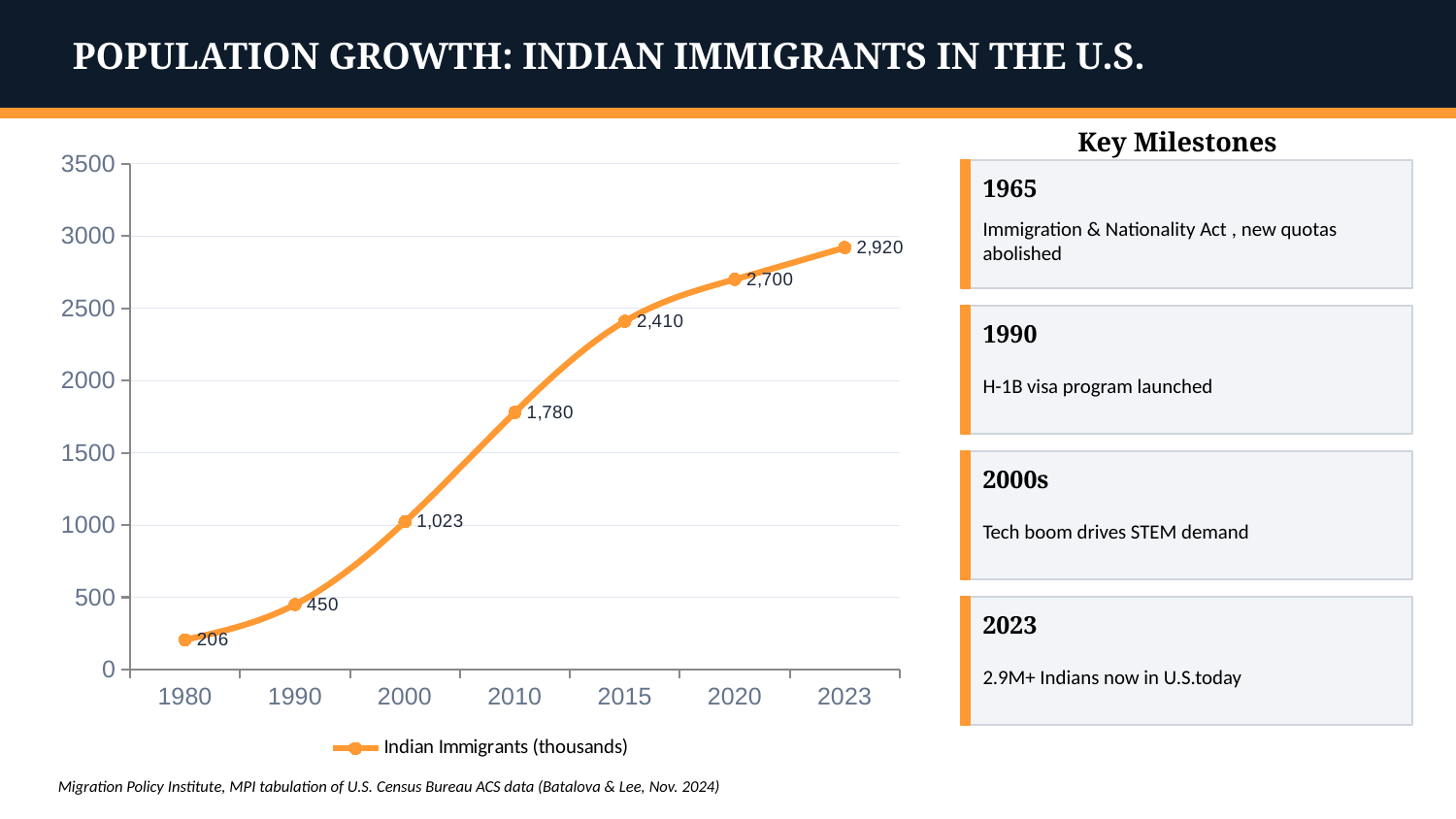
What is the value for 2010? 1,780 How many series does the legend list? 1 What is the difference between the values for 2000 and 1990? 573 What is the value for 2023? 2,920 What kind of chart is shown? line chart What is the value for 1980? 206 What is the difference between the values for 2020 and 2015? 290 Which year has the highest value? 2023 Do the values rise or fall from 1980 to 2023? rise Which year has the lowest value? 1980 Which is larger, the value for 2010 or the value for 2015? 2015 How many data points are plotted on the chart? 7